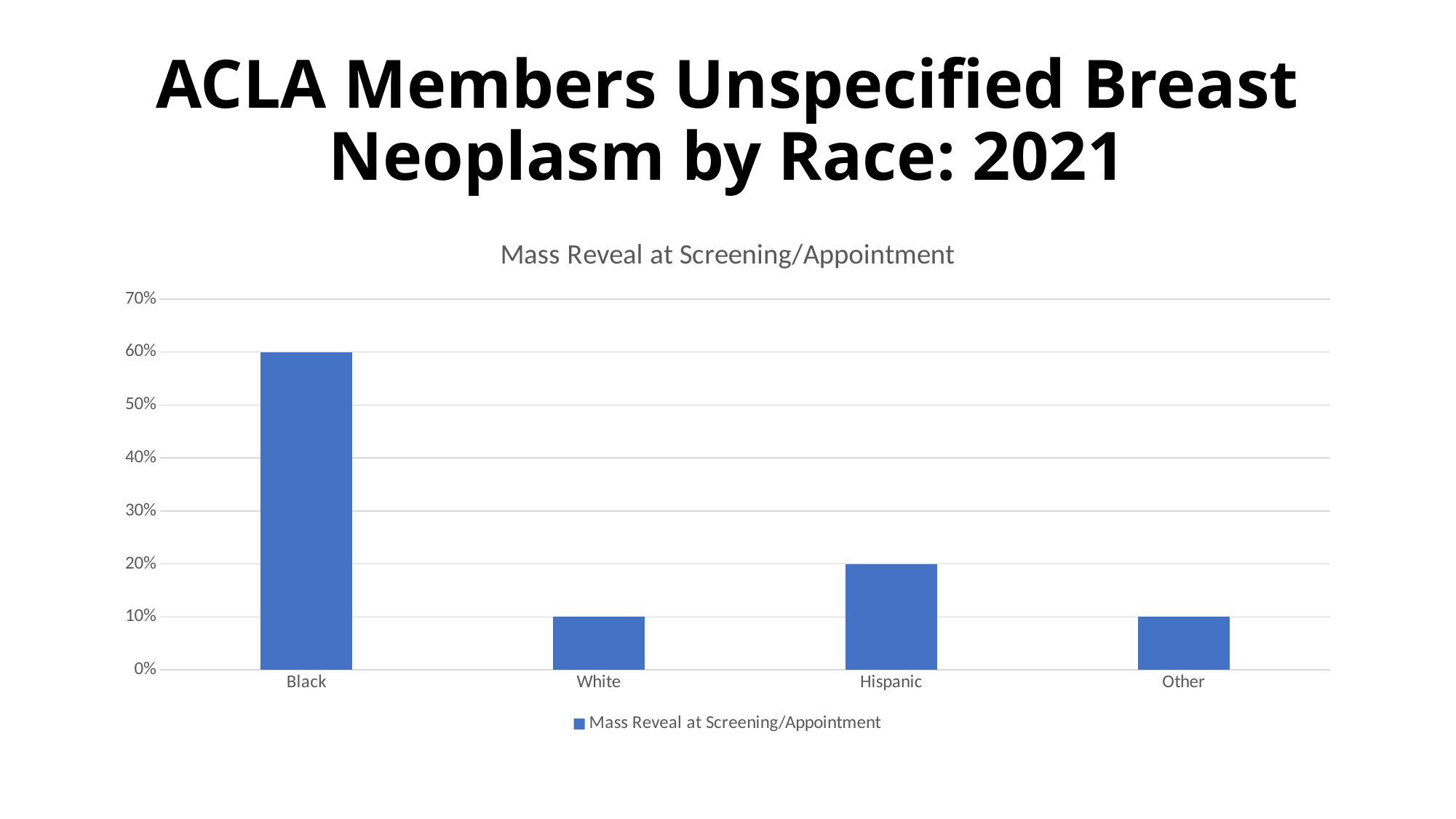
What is the value for Black in the Mass Reveal at Screening/Appointment chart? 60% What is the value for Hispanic? 20% Which is larger, the value for Hispanic or the value for Other? Hispanic What is the difference between the values for Hispanic and White? 10% Which category has the highest value? Black What kind of chart is shown on the slide? bar chart How many series does the legend list? 1 What is the title of the chart? Mass Reveal at Screening/Appointment Is the value for Black greater or less than 50%? greater What is the difference between the values for Black and Hispanic? 40% How many categories are shown on the x axis? 4 What is the value for White? 10%